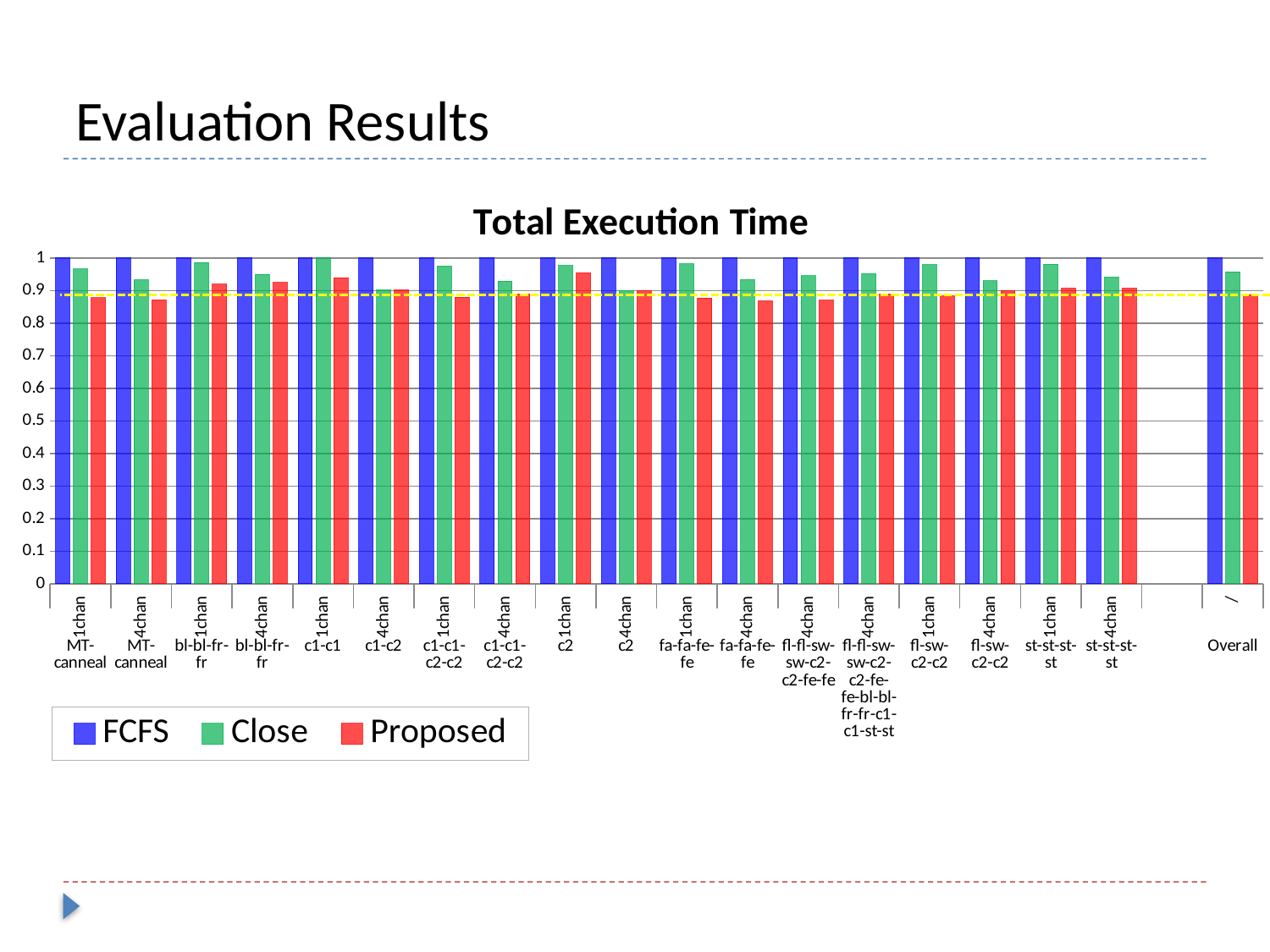
Is the Proposed value for c1-c1 1chan greater or less than 0.9? greater What kind of chart is shown on the slide? bar chart What is the FCFS value for MT-canneal 1chan? 1 How many series does the legend list? 3 What is the FCFS value for Overall? 1 Which series are listed in the legend? FCFS, Close, Proposed What is the title of the chart? Total Execution Time Is the Proposed value for MT-canneal 1chan greater or less than 0.9? less For MT-canneal 1chan, which is larger, the Close value or the Proposed value? Close Is the Close value for MT-canneal 1chan greater or less than 0.9? greater For MT-canneal 4chan, which series has the lowest value? Proposed